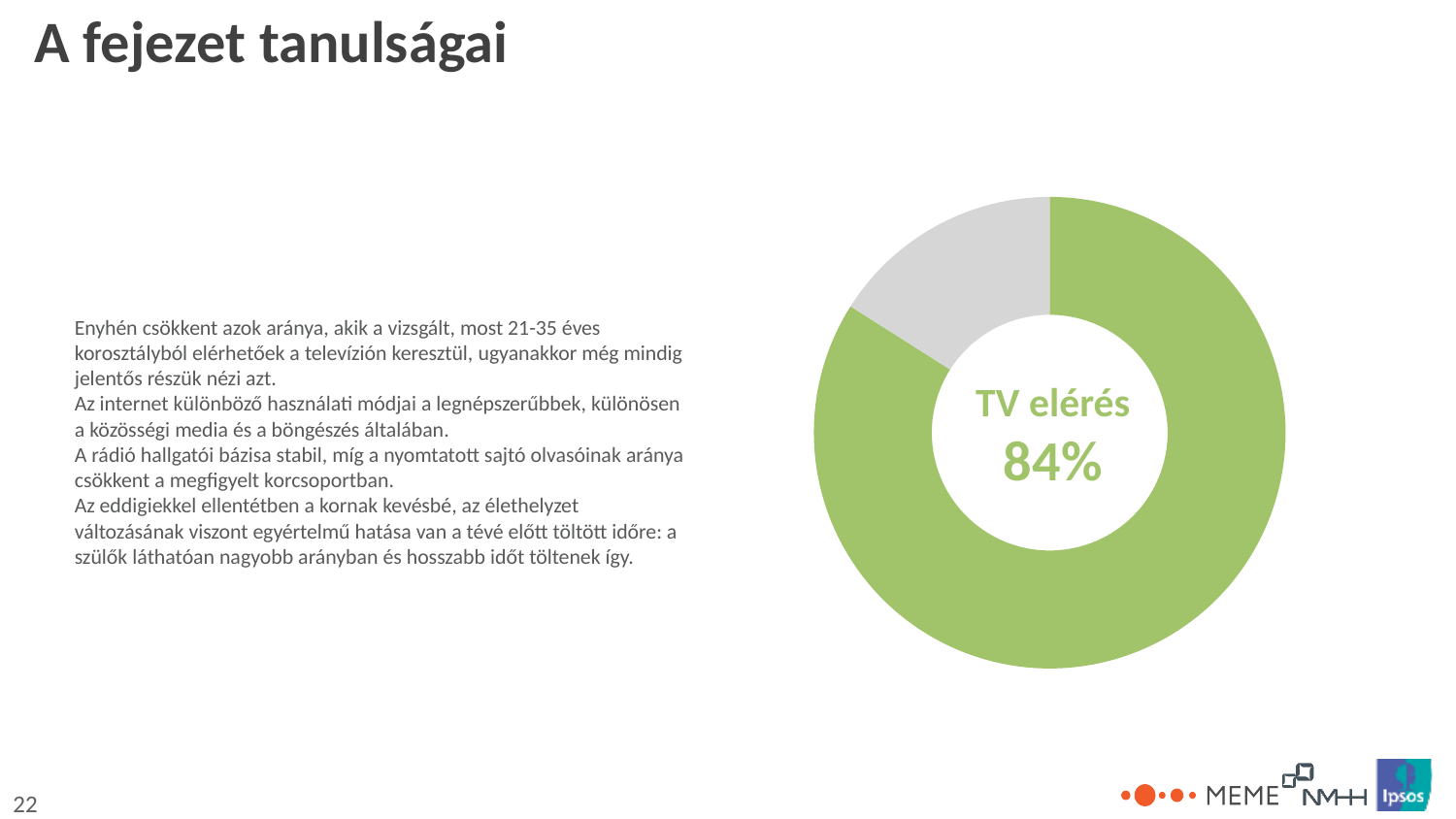
What share of the donut chart does the green slice represent? 84% How many slices does the donut chart have? 2 What label is printed in the centre of the donut chart above the percentage? TV elérés What colour is the slice representing TV elérés in the donut chart? green Which slice of the donut chart is the largest? the green slice (TV elérés, 84%) What kind of chart is shown on the right side of the slide? donut (pie) chart What percentage is printed in the centre of the donut chart? 84% Which slice of the donut chart is larger, the green one or the grey one? the green one